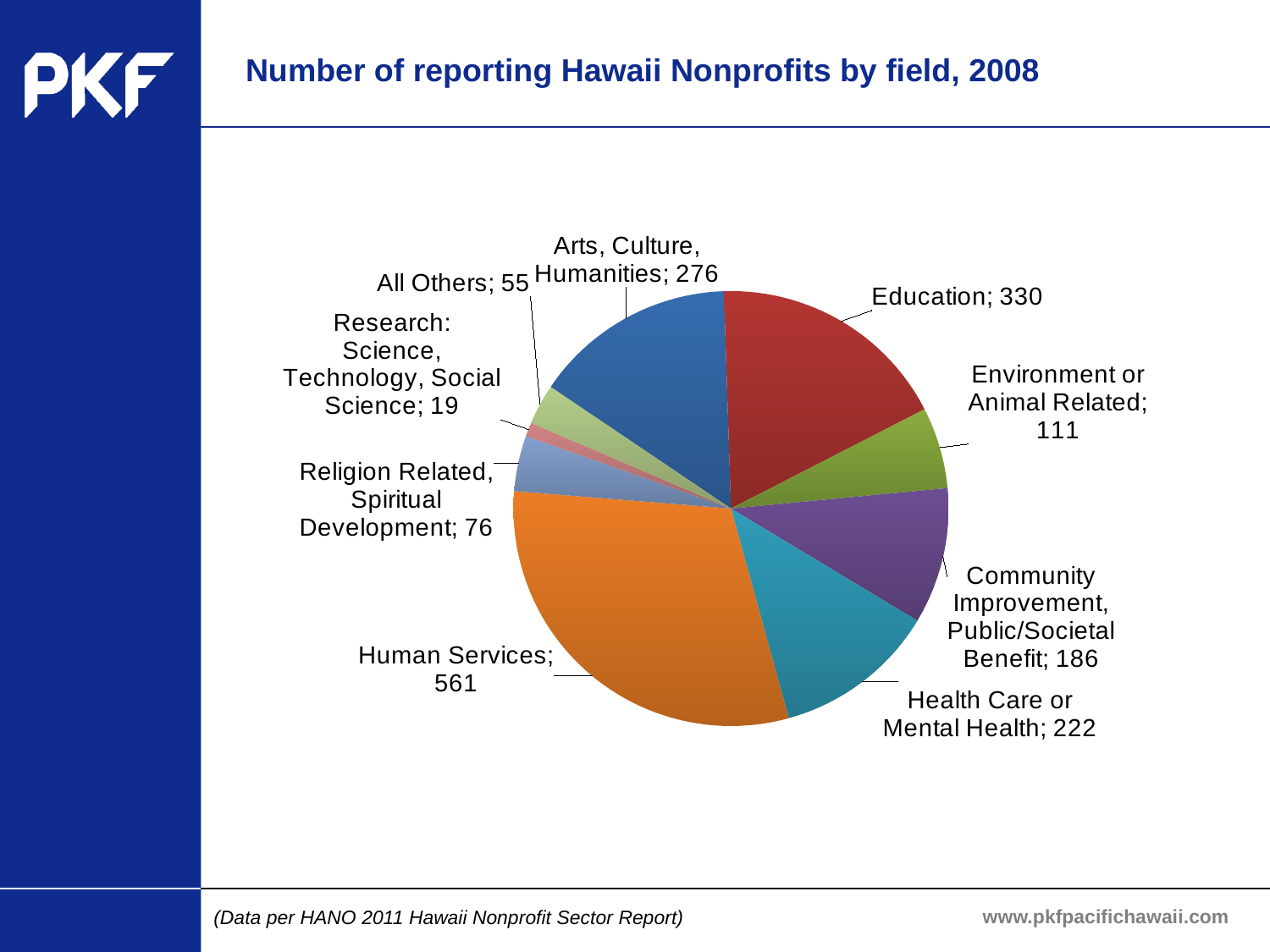
Which is larger, Community Improvement, Public/Societal Benefit or Environment or Animal Related? Community Improvement, Public/Societal Benefit What is the title of the chart? Number of reporting Hawaii Nonprofits by field, 2008 What is the value for Health Care or Mental Health? 222 What is the value for Human Services? 561 How many fields (slices) are shown in the pie chart? 9 What kind of chart is shown on the slide? Pie chart What is the difference between Arts, Culture, Humanities and Health Care or Mental Health? 54 Which field has the largest number of reporting nonprofits? Human Services What is the value for Research: Science, Technology, Social Science? 19 What is the value for Education? 330 What is the difference between Human Services and Education? 231 Which field has the smallest number of reporting nonprofits? Research: Science, Technology, Social Science